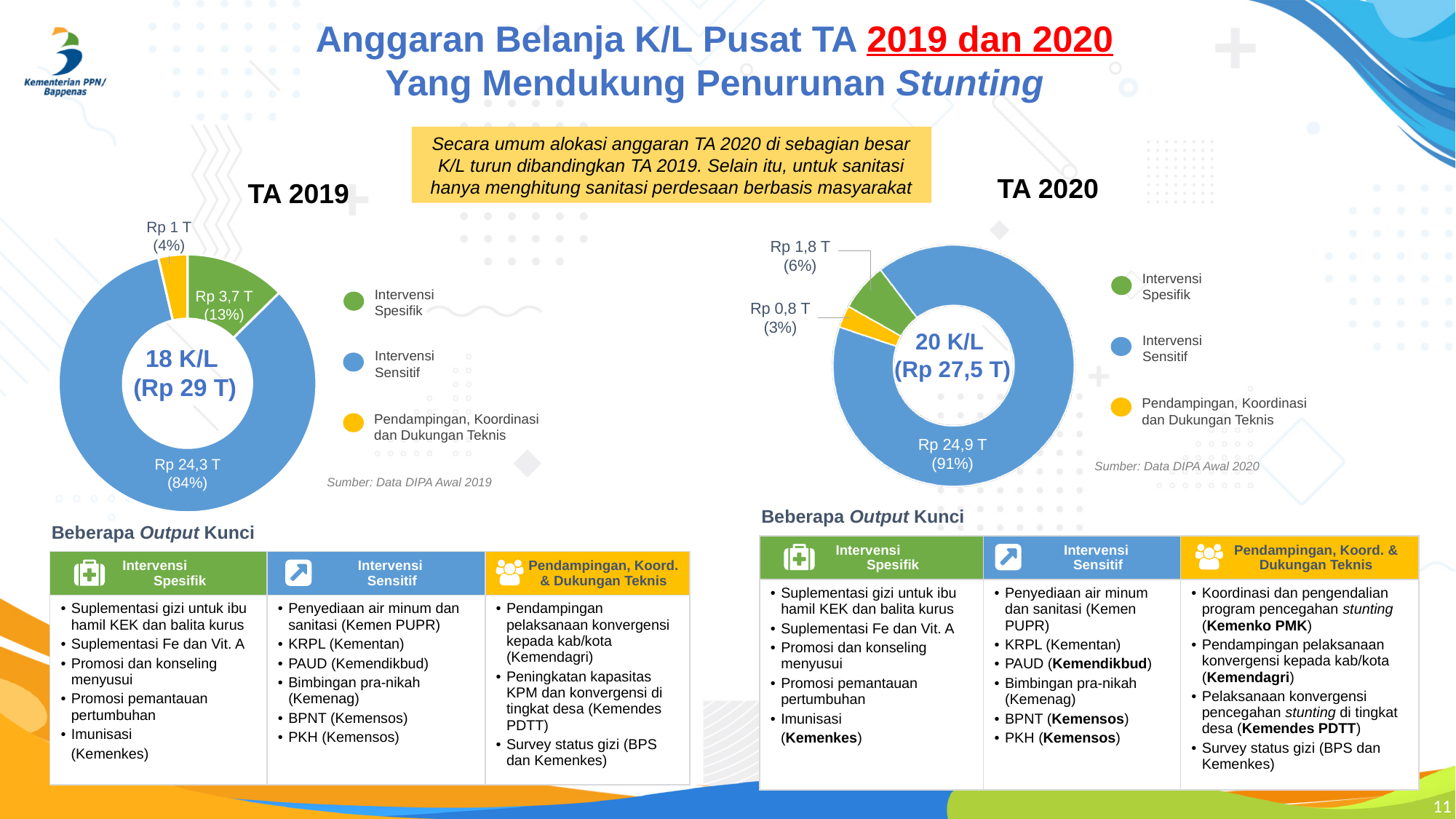
In the TA 2019 chart, what share of the total does Intervensi Spesifik represent? 13% In the TA 2020 chart, what is the value for Pendampingan, Koordinasi dan Dukungan Teknis? Rp 0,8 T What kind of chart is the TA 2019 chart? Pie (donut) chart What total amount is shown in the centre of the TA 2020 chart? Rp 27,5 T How many categories does the TA 2020 chart show? 3 In the TA 2019 chart, which colour represents Intervensi Sensitif? Blue Which is larger: Intervensi Spesifik in the TA 2019 chart or Intervensi Spesifik in the TA 2020 chart? TA 2019 In the TA 2019 chart, which category has the smallest value? Pendampingan, Koordinasi dan Dukungan Teknis In the TA 2020 chart, what is the difference between Intervensi Spesifik and Pendampingan, Koordinasi dan Dukungan Teknis? Rp 1 T In the TA 2019 chart, what is the value for Intervensi Sensitif? Rp 24,3 T In the TA 2020 chart, what share of the total does Intervensi Sensitif represent? 91% In the TA 2020 chart, which category has the largest value? Intervensi Sensitif